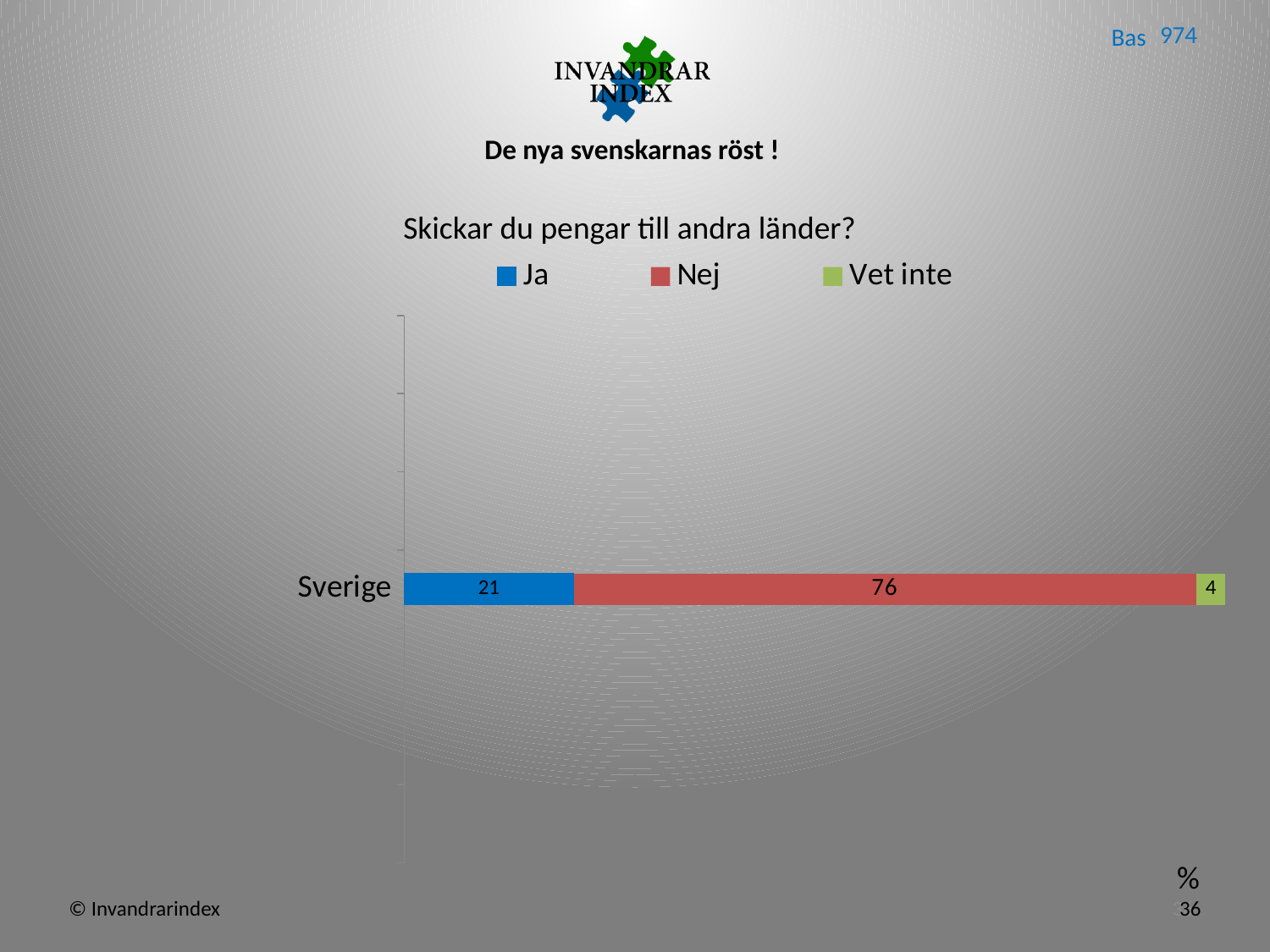
What is the value for "Vet inte" for Sverige? 4 What is the value for "Ja" for Sverige? 21 How many categories are shown on the chart? 1 What kind of chart is shown on the slide? Stacked bar chart What is the difference between the "Nej" and "Ja" values for Sverige? 55 How many series does the legend list? 3 What is the title of the chart? Skickar du pengar till andra länder? Which series has the lowest value for Sverige? Vet inte Which series has the highest value for Sverige? Nej What is the total of the stacked bar for Sverige? 101 Which is larger for Sverige, "Ja" or "Vet inte"? Ja What is the value for "Nej" for Sverige? 76